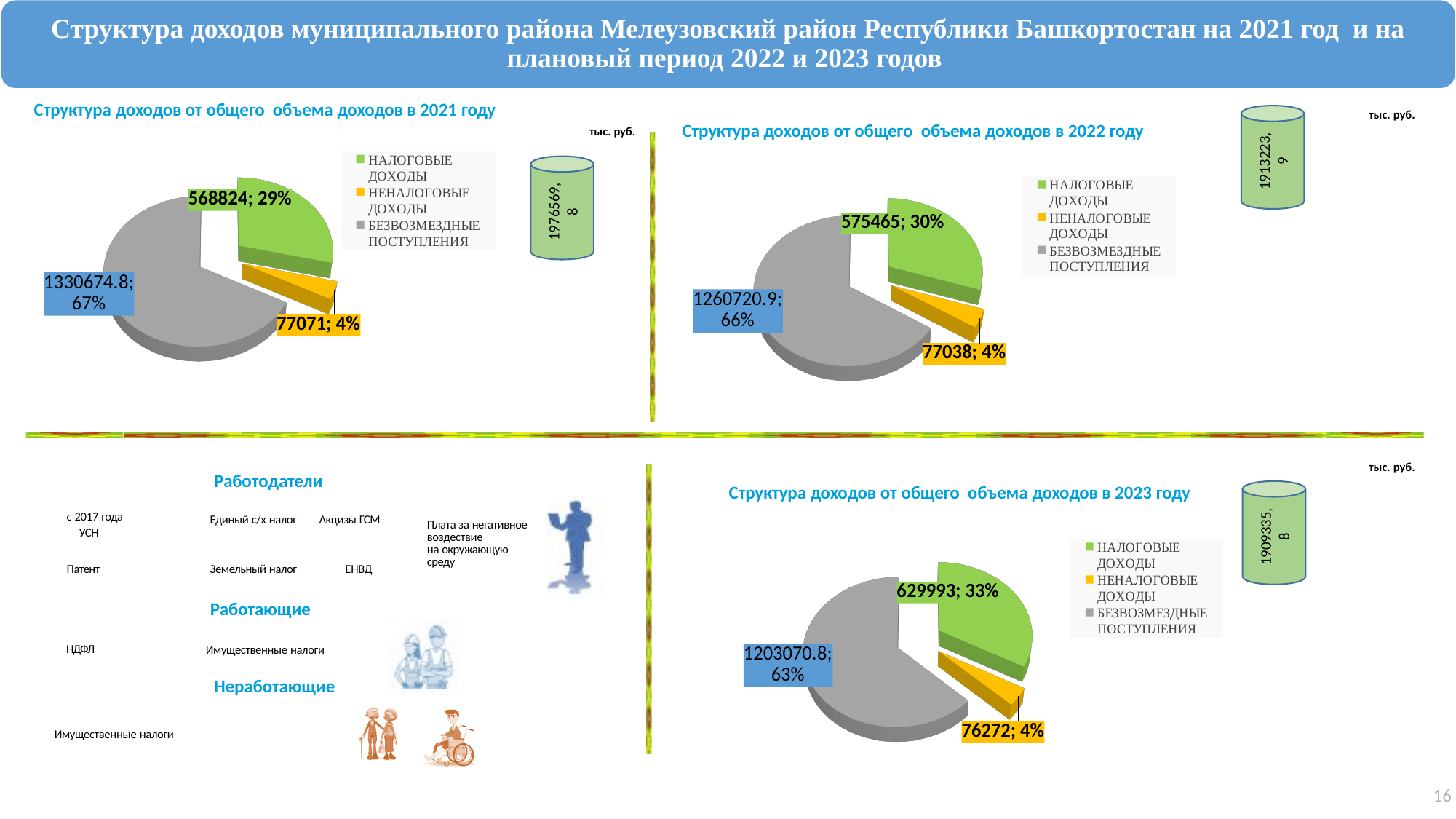
In the chart 'Структура доходов от общего объема доходов в 2023 году', what is the difference between the values for НАЛОГОВЫЕ ДОХОДЫ and НЕНАЛОГОВЫЕ ДОХОДЫ? 553721 What kind of chart is 'Структура доходов от общего объема доходов в 2021 году'? Pie chart In the chart 'Структура доходов от общего объема доходов в 2021 году', what is the value for НАЛОГОВЫЕ ДОХОДЫ? 568824 In the chart 'Структура доходов от общего объема доходов в 2023 году', what is the value for БЕЗВОЗМЕЗДНЫЕ ПОСТУПЛЕНИЯ? 1203070.8 In the chart 'Структура доходов от общего объема доходов в 2021 году', what share of the pie is БЕЗВОЗМЕЗДНЫЕ ПОСТУПЛЕНИЯ? 67% In the chart 'Структура доходов от общего объема доходов в 2023 году', what share of the pie is НЕНАЛОГОВЫЕ ДОХОДЫ? 4% In the chart 'Структура доходов от общего объема доходов в 2021 году', which category has the smallest slice? НЕНАЛОГОВЫЕ ДОХОДЫ In the chart 'Структура доходов от общего объема доходов в 2022 году', what is the value for НЕНАЛОГОВЫЕ ДОХОДЫ? 77038 In the chart 'Структура доходов от общего объема доходов в 2023 году', which is larger: НАЛОГОВЫЕ ДОХОДЫ or БЕЗВОЗМЕЗДНЫЕ ПОСТУПЛЕНИЯ? БЕЗВОЗМЕЗДНЫЕ ПОСТУПЛЕНИЯ In the chart 'Структура доходов от общего объема доходов в 2022 году', what share of the pie is НАЛОГОВЫЕ ДОХОДЫ? 30% In the chart 'Структура доходов от общего объема доходов в 2022 году', which category has the largest slice? БЕЗВОЗМЕЗДНЫЕ ПОСТУПЛЕНИЯ How many categories does the legend of the chart 'Структура доходов от общего объема доходов в 2022 году' list? 3